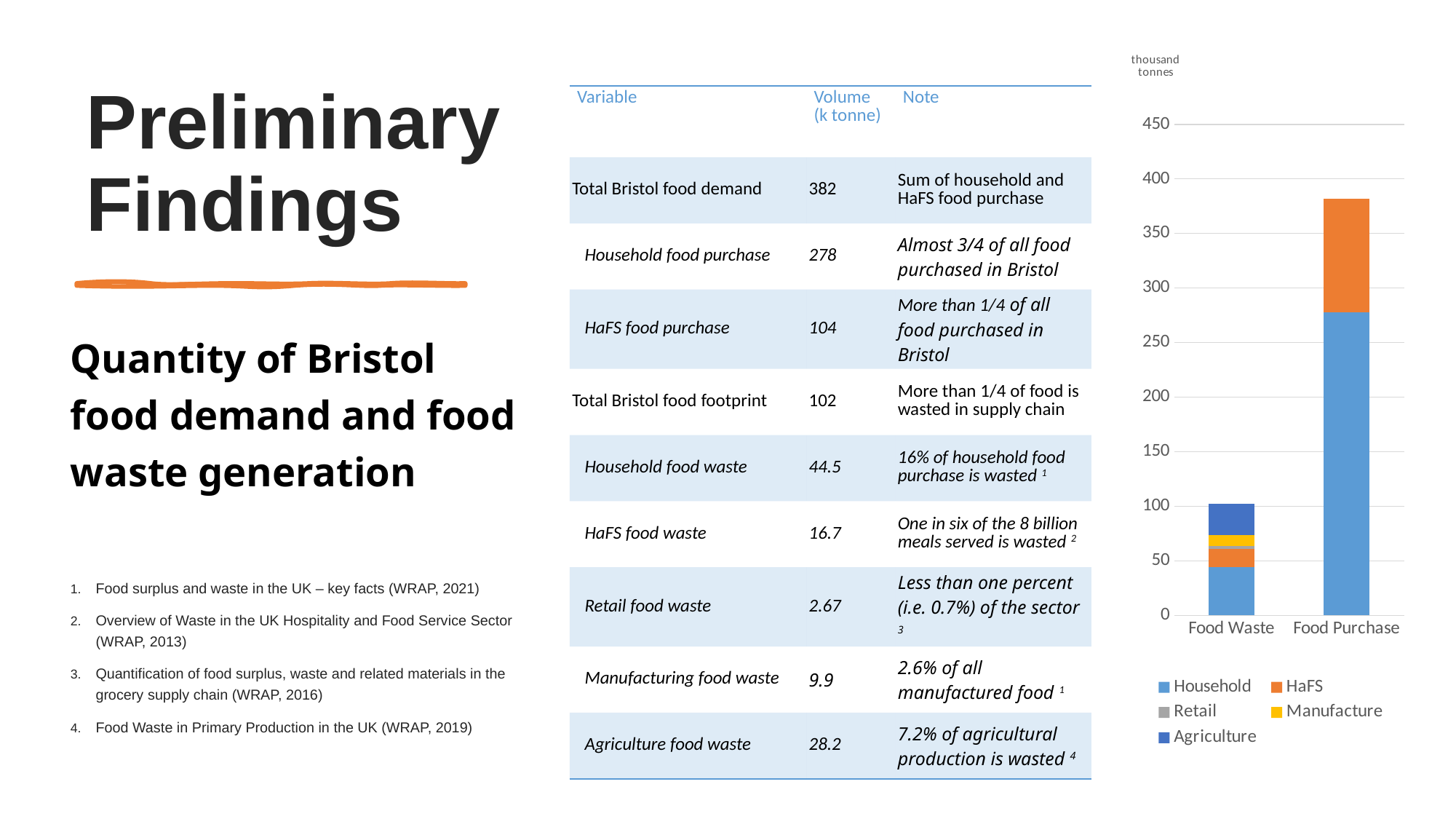
How many series does the chart's legend list? 5 Which category has the shorter stacked bar in the chart? Food Waste Is the Household segment of the Food Purchase bar greater or less than 250? greater Is the total height of the Food Waste bar greater or less than 150? less Is the total height of the Food Purchase bar greater or less than 350? greater Which category has the taller stacked bar, Food Waste or Food Purchase? Food Purchase In the Food Purchase bar, which segment is larger, Household or HaFS? Household How many categories are shown on the x axis of the chart? 2 What unit is shown above the chart's vertical axis? thousand tonnes What kind of chart is shown on the right of the slide? bar chart Which colour represents HaFS in the chart's legend? orange